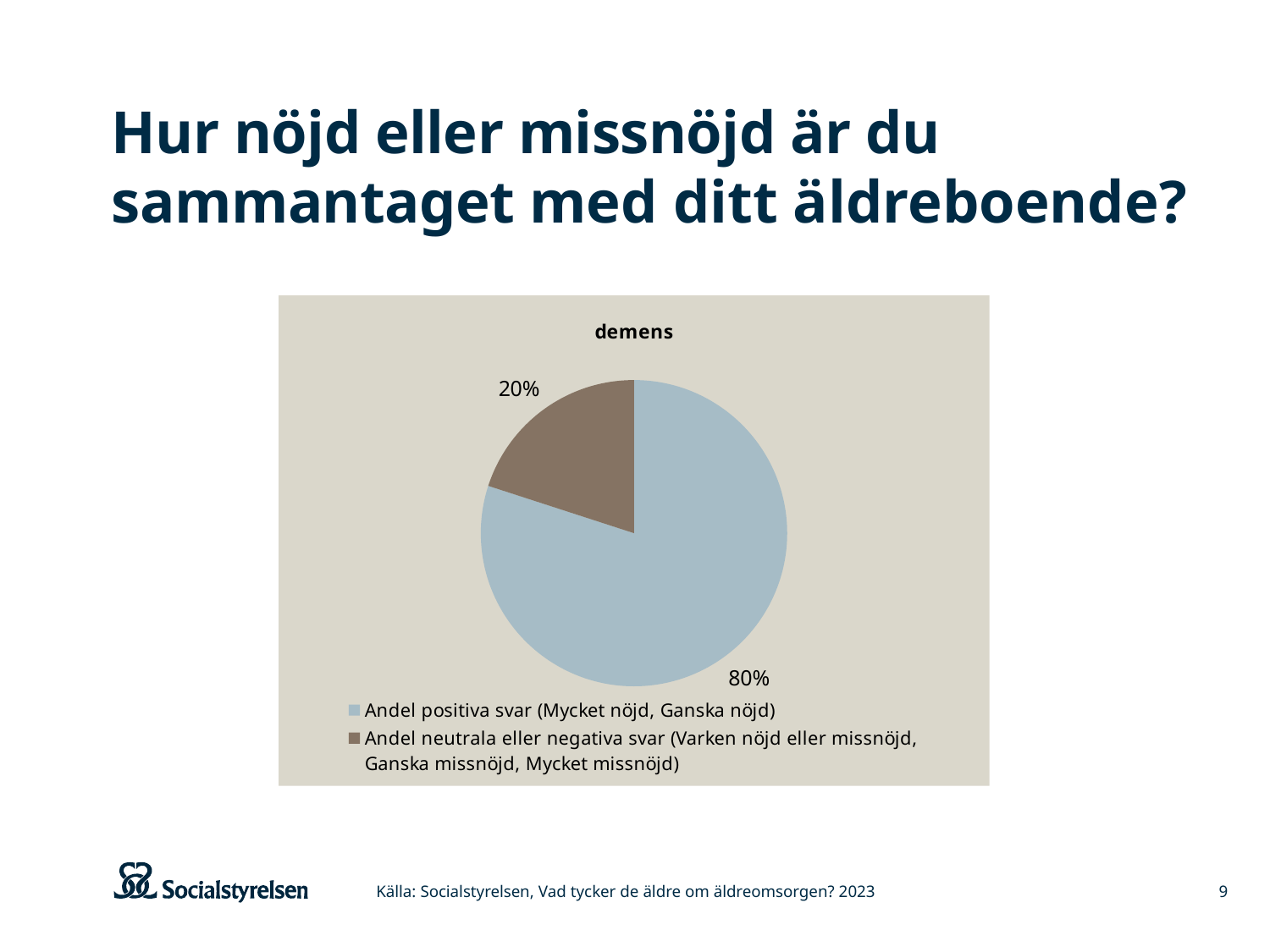
Which slice is the largest? Andel positiva svar (Mycket nöjd, Ganska nöjd) How many slices does the pie chart have? 2 What colour is the slice for 'Andel positiva svar (Mycket nöjd, Ganska nöjd)'? light blue How many entries does the legend list? 2 What share of the pie is 'Andel neutrala eller negativa svar (Varken nöjd eller missnöjd, Ganska missnöjd, Mycket missnöjd)'? 20% Which slice is the smallest? Andel neutrala eller negativa svar (Varken nöjd eller missnöjd, Ganska missnöjd, Mycket missnöjd) What share of the pie is 'Andel positiva svar (Mycket nöjd, Ganska nöjd)'? 80% What is the difference between the positive share and the neutral or negative share? 60% What is the chart's title? demens Which is larger: the share of positive answers or the share of neutral or negative answers? Andel positiva svar (Mycket nöjd, Ganska nöjd) What kind of chart is shown on the slide? pie chart